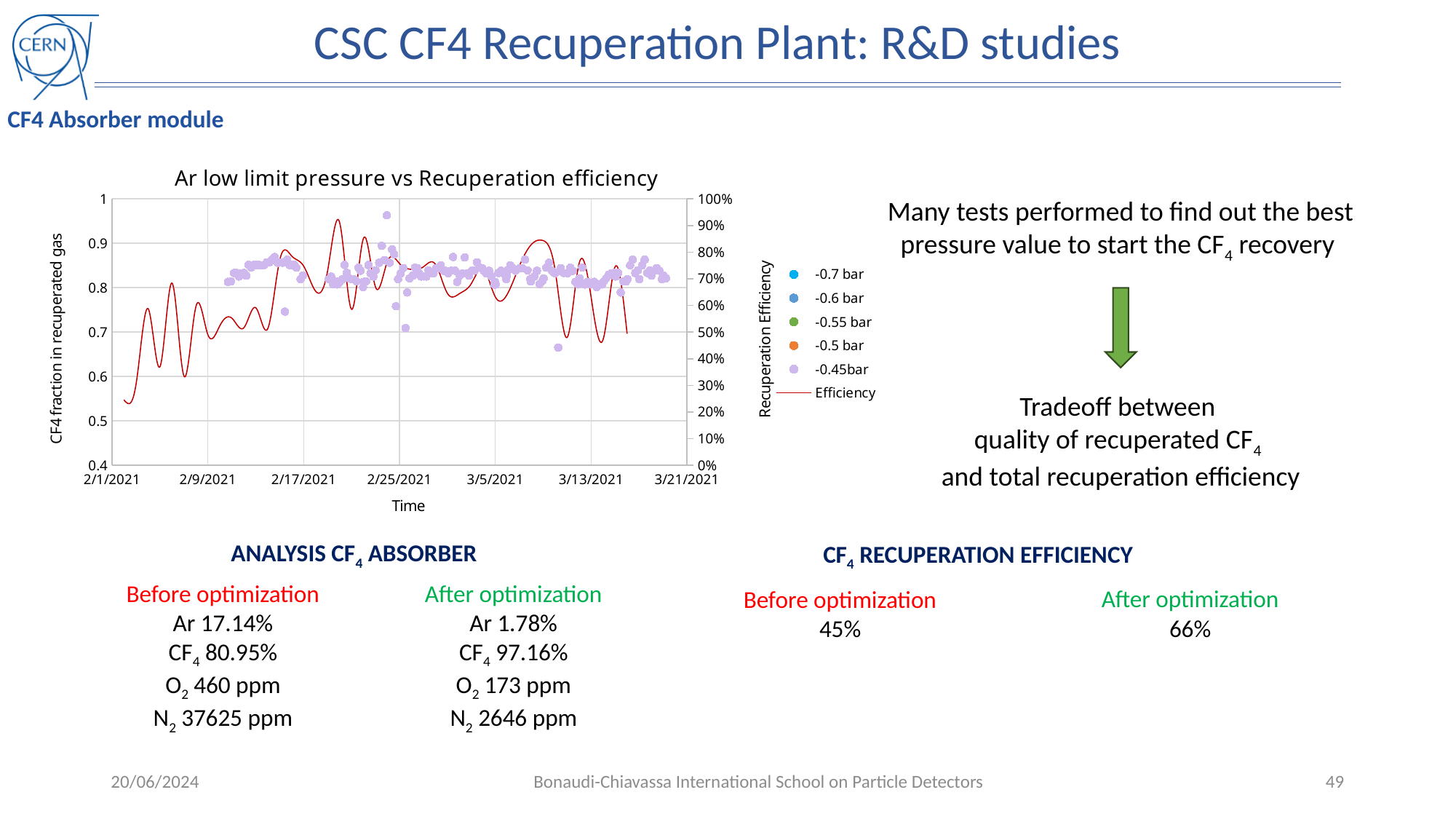
What kind of chart is shown on the slide? Line chart with scatter points What is the title of the chart on the slide? Ar low limit pressure vs Recuperation efficiency Which legend entry in the chart is drawn as a line rather than as dots? Efficiency Is the highest peak of the red line on the chart greater or less than 0.9 on the left axis? greater What is the minimum value shown on the left-hand (CF4 fraction in recuperated gas) axis of the chart? 0.4 How many entries does the chart's legend list? 6 What is the label of the chart's x axis? Time Is the value of the red line at the start of the chart (2/1/2021) greater or less than 0.6 on the left axis? less Between 2/1/2021 and 2/17/2021, does the red line on the chart generally rise or fall? rise What is the maximum value shown on the right-hand (Recuperation Efficiency) axis of the chart? 100% How many date tick labels are shown on the chart's x axis? 7